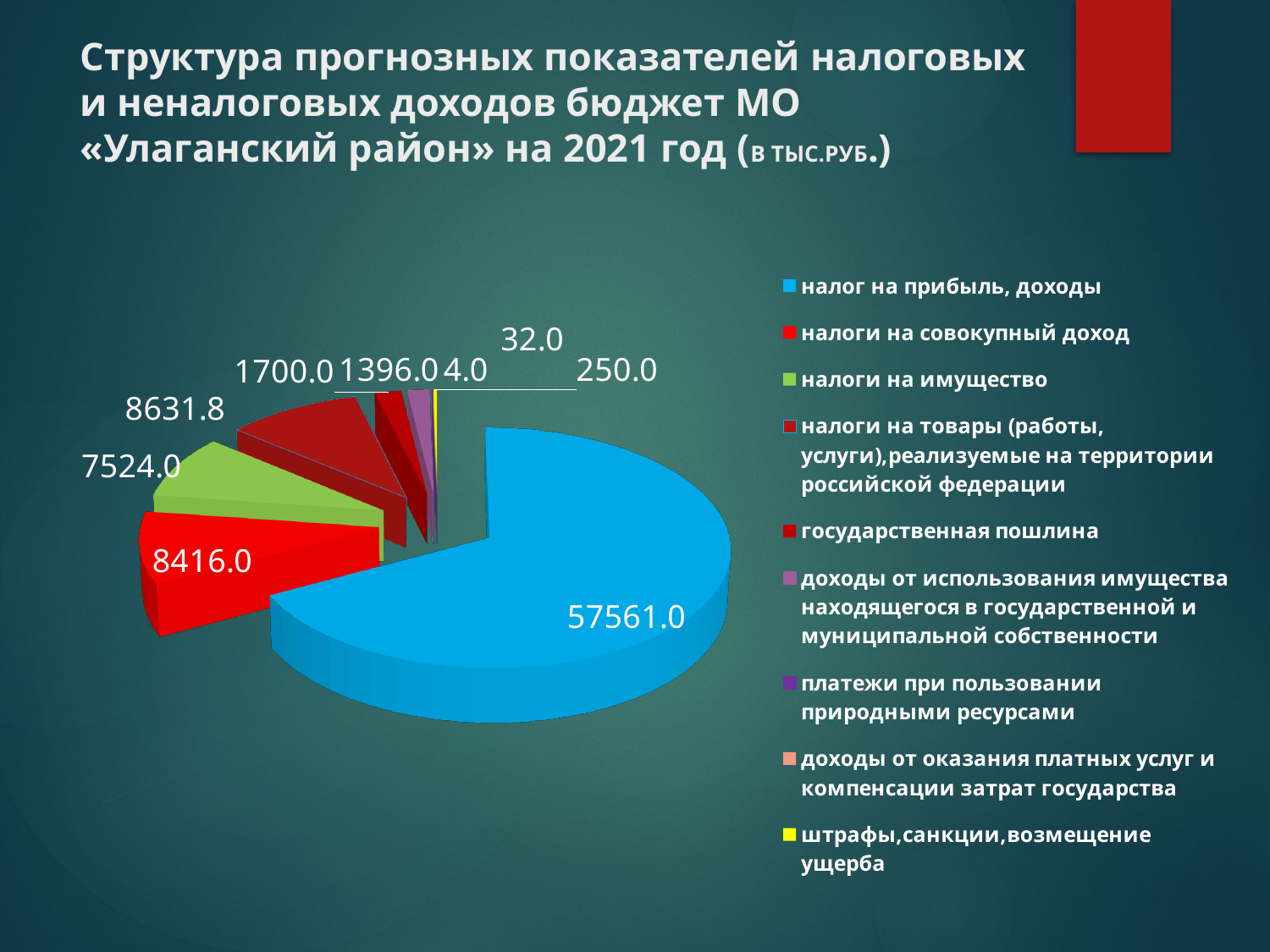
Which category has the largest slice of the pie? налог на прибыль, доходы What is the value for «налоги на товары (работы, услуги), реализуемые на территории российской федерации»? 8631.8 What is the value for «государственная пошлина»? 1700.0 What is the value for «налоги на совокупный доход»? 8416.0 What colour is the slice for «налог на прибыль, доходы»? blue What is the smallest value labelled on the pie chart? 4.0 What is the difference between «налоги на совокупный доход» and «налоги на имущество»? 892.0 Which is larger: «налоги на товары (работы, услуги)» or «налоги на совокупный доход»? налоги на товары (работы, услуги), реализуемые на территории российской федерации What kind of chart is shown on the slide? pie chart What is the value for «налог на прибыль, доходы»? 57561.0 How many categories does the legend list? 9 What is the value for «налоги на имущество»? 7524.0